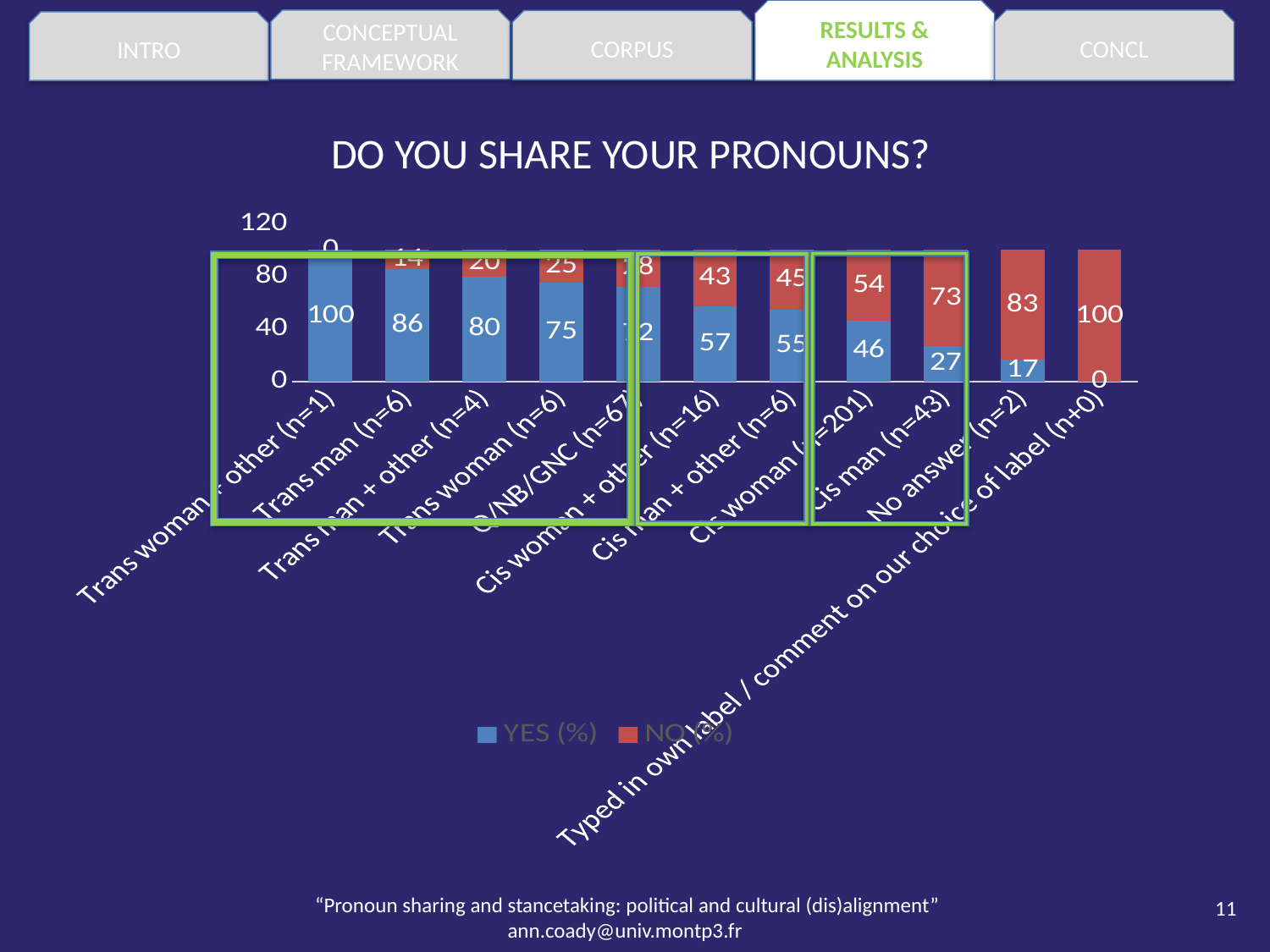
What kind of chart is shown on the slide? bar chart What is the total of the stacked bar for Cis man (n=43)? 100 What is the difference between the YES (%) values for Trans man (n=6) and Trans woman (n=6)? 11 How many series does the legend list? 2 What is the YES (%) value for No answer (n=2)? 17 What is the YES (%) value for Trans man (n=6)? 86 How many categories (bars) are shown on the x axis? 11 Which has a higher YES (%) value, Trans man (n=6) or Cis man (n=43)? Trans man (n=6) What is the NO (%) value for Cis man (n=43)? 73 What is the NO (%) value for Cis woman + other (n=16)? 43 What are the two series named in the legend? YES (%) and NO (%) What is the NO (%) value for Trans woman (n=6)? 25